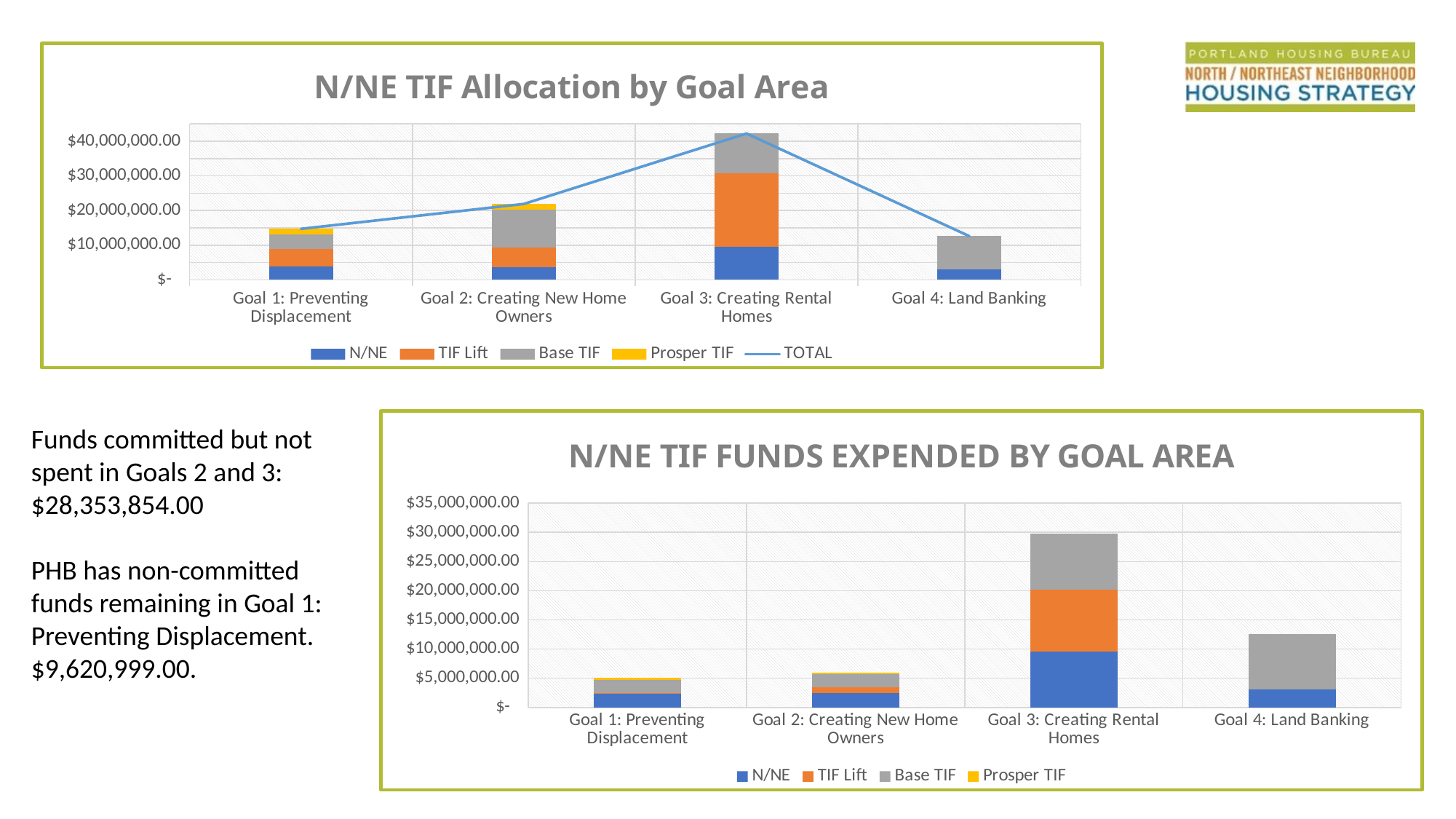
In the top chart, 'N/NE TIF Allocation by Goal Area', which series is drawn as a line rather than bars? TOTAL What type of chart is the bottom chart, 'N/NE TIF FUNDS EXPENDED BY GOAL AREA'? Stacked bar chart In the bottom chart, 'N/NE TIF FUNDS EXPENDED BY GOAL AREA', how many series does the legend list? 4 In the top chart, 'N/NE TIF Allocation by Goal Area', how many goal areas are shown on the x axis? 4 In the top chart, 'N/NE TIF Allocation by Goal Area', is the total for Goal 4: Land Banking greater or less than $20,000,000.00? less In the bottom chart, 'N/NE TIF FUNDS EXPENDED BY GOAL AREA', which has the larger total: Goal 4: Land Banking or Goal 1: Preventing Displacement? Goal 4: Land Banking In the top chart, 'N/NE TIF Allocation by Goal Area', is the total for Goal 3: Creating Rental Homes greater or less than $30,000,000.00? greater In the top chart, 'N/NE TIF Allocation by Goal Area', how many entries does the legend list? 5 What type of chart is the top chart, 'N/NE TIF Allocation by Goal Area'? Stacked bar chart with a line In the top chart, 'N/NE TIF Allocation by Goal Area', which goal area has the highest total allocation? Goal 3: Creating Rental Homes In the bottom chart, 'N/NE TIF FUNDS EXPENDED BY GOAL AREA', is the total for Goal 3: Creating Rental Homes greater or less than $25,000,000.00? greater In the bottom chart, 'N/NE TIF FUNDS EXPENDED BY GOAL AREA', which goal area has the highest total funds expended? Goal 3: Creating Rental Homes